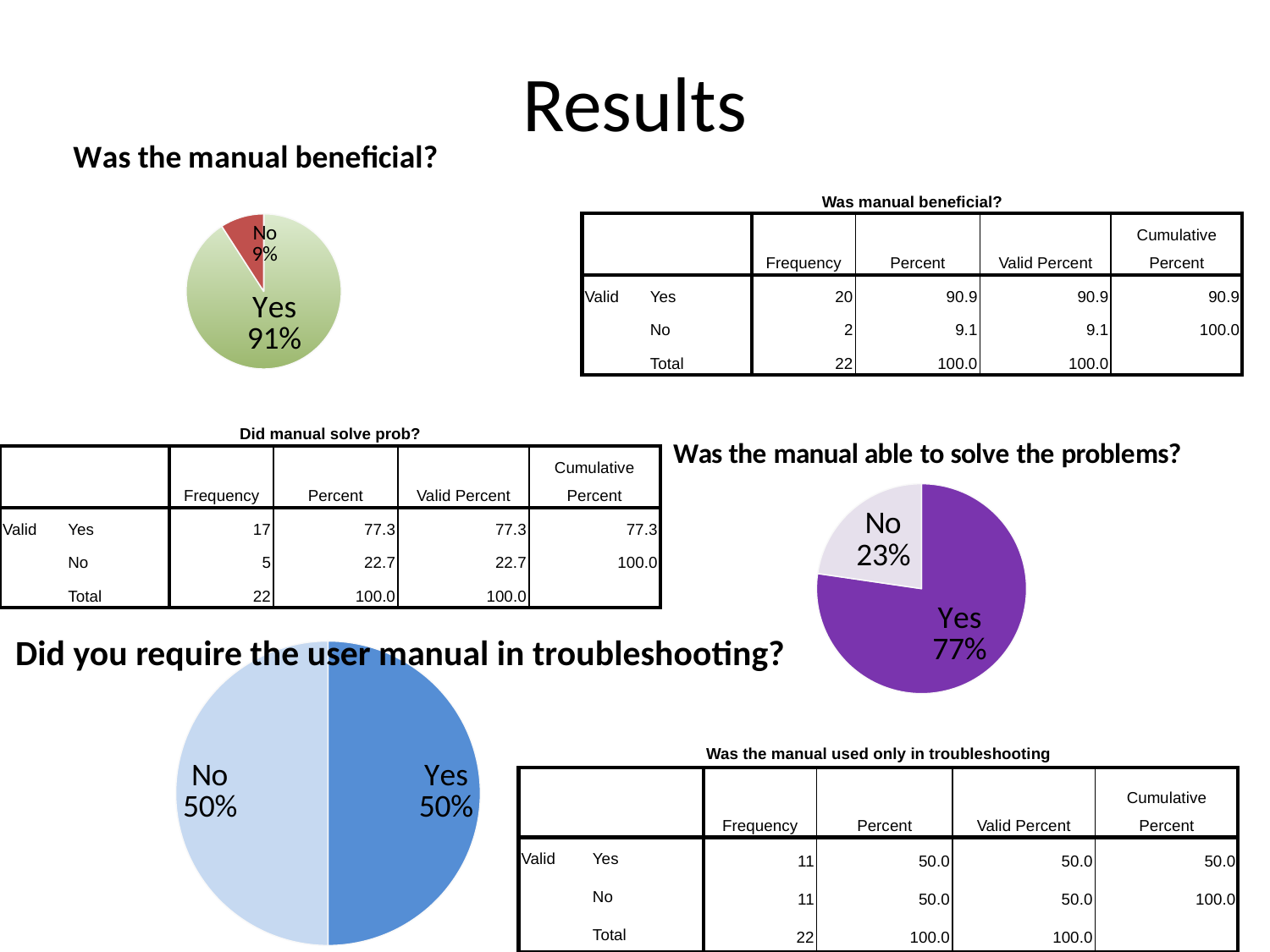
What type of chart is used for 'Was the manual beneficial?'? pie chart In the 'Was the manual beneficial?' pie chart, what is the value shown for No? 9% In the 'Was the manual able to solve the problems?' pie chart, which slice is the largest? Yes In the 'Was the manual beneficial?' pie chart, which slice is the smallest? No In the 'Did you require the user manual in troubleshooting?' pie chart, how many slices does the pie have? 2 In the 'Was the manual beneficial?' pie chart, what share of the pie is the Yes slice? 91% In the 'Was the manual able to solve the problems?' pie chart, is the Yes slice larger or smaller than the No slice? larger In the 'Was the manual able to solve the problems?' pie chart, what share of the pie is the No slice? 23% In the 'Was the manual able to solve the problems?' pie chart, what is the value shown for Yes? 77% In the 'Was the manual beneficial?' pie chart, what is the difference between the Yes and No percentages? 82% In the 'Did you require the user manual in troubleshooting?' pie chart, what share of the pie is the Yes slice? 50% How many pie charts are shown on the slide? 3